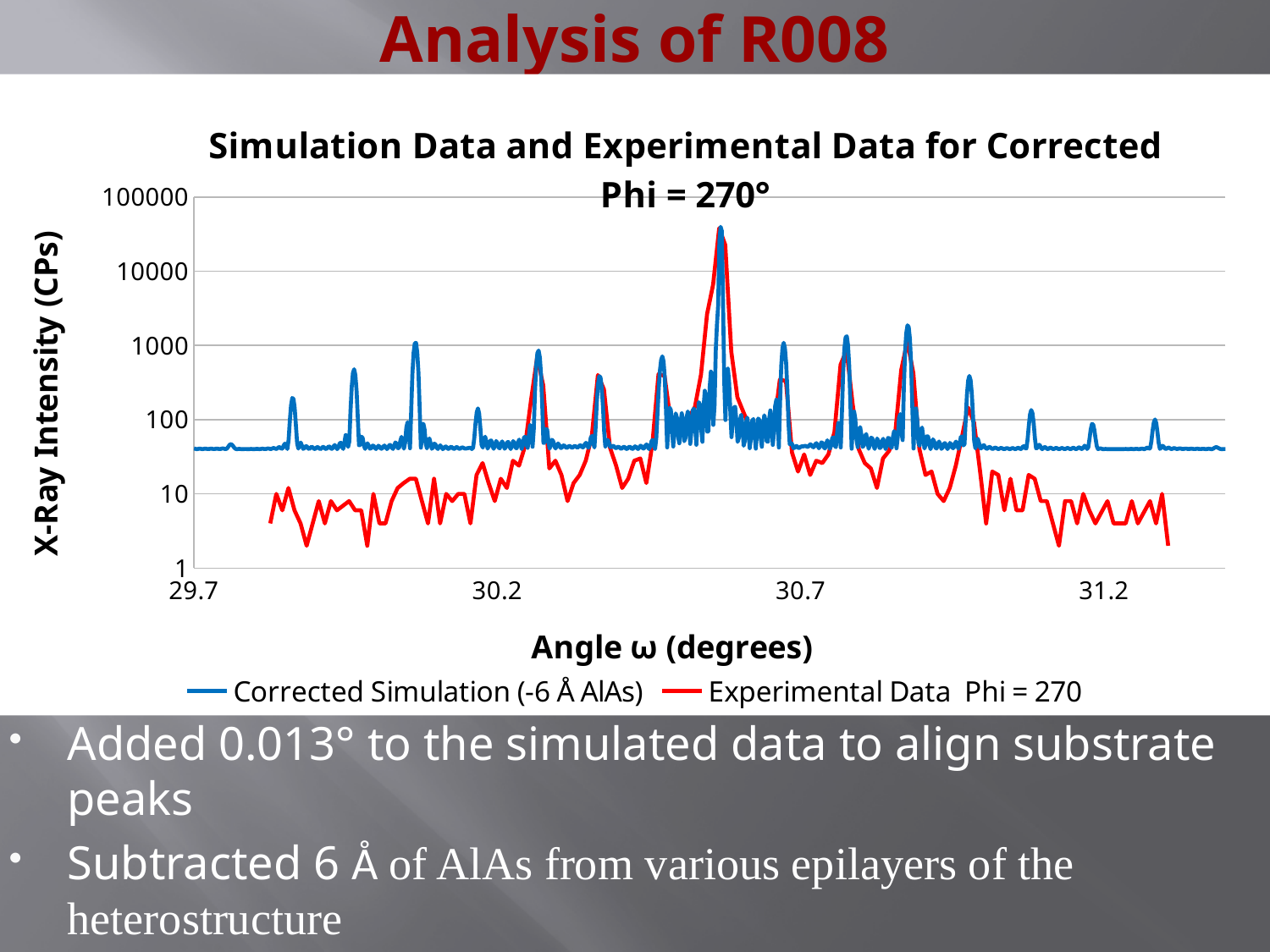
What is the title of the chart? Simulation Data and Experimental Data for Corrected Phi = 270° Is the baseline value of the Corrected Simulation series at about 29.7 degrees greater or less than 10? greater Is the baseline value of the Corrected Simulation series at about 29.7 degrees greater or less than 100? less At about 31.2 degrees, which series has the larger value, Corrected Simulation or Experimental Data? Corrected Simulation At about 29.8 degrees, which series has the larger value, Corrected Simulation or Experimental Data? Corrected Simulation What kind of chart is shown on the slide? line chart How many series does the legend list? 2 What is the label of the y-axis? X-Ray Intensity (CPs) Is the peak value of the Corrected Simulation series near 30.57 degrees greater or less than 10000? greater